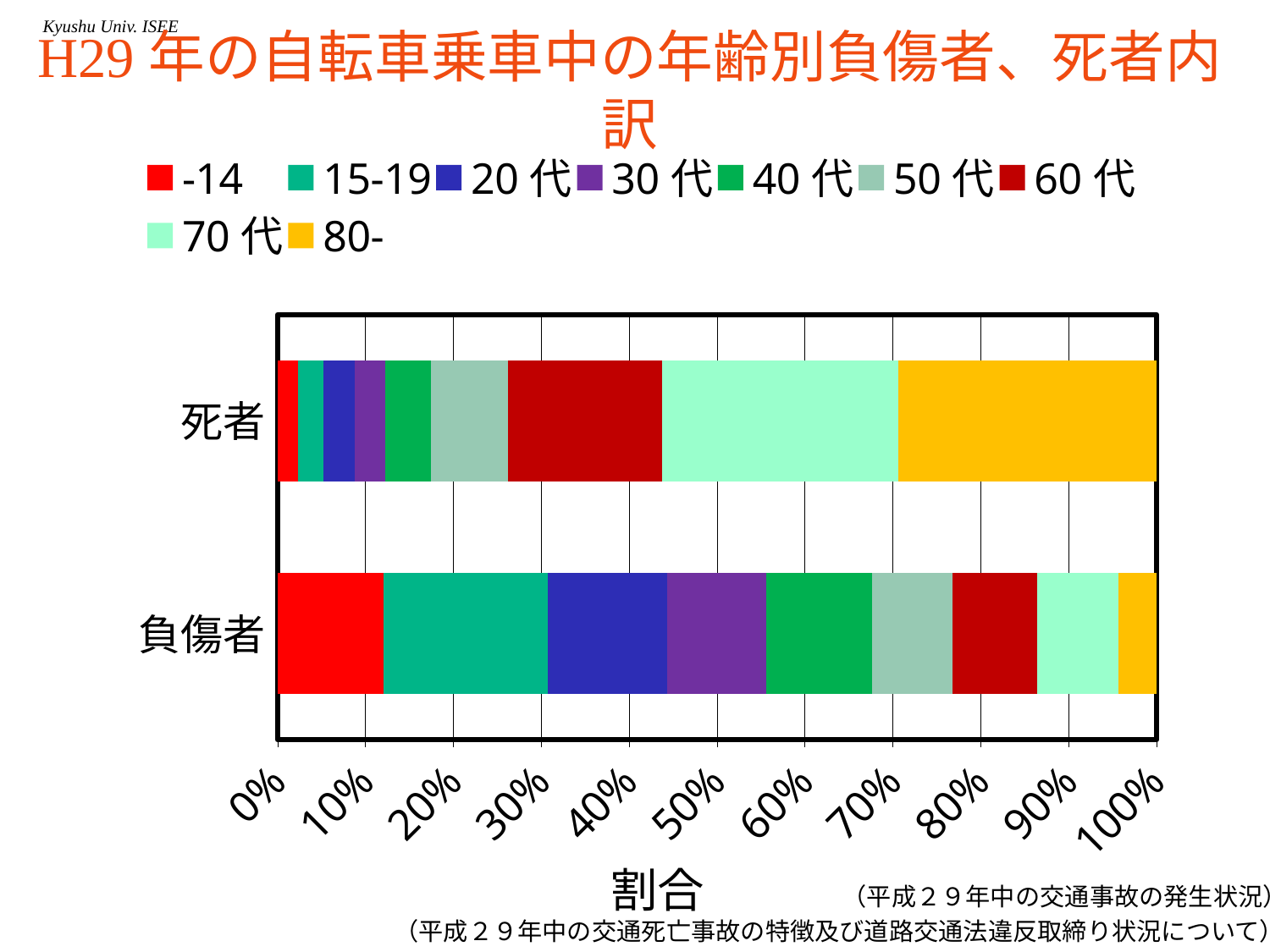
What kind of chart is shown on the slide? Stacked bar chart Within the 負傷者 bar, which age group has the largest share? 15-19 How many bars (categories) does the chart show? 2 Is the share of the -14 group larger in the 死者 bar or the 負傷者 bar? 負傷者 How many series does the legend list? 9 Within the 死者 bar, which age group has the smallest share? -14 Is the share of the -14 group in the 死者 bar greater or less than 10%? less Is the share of the 80- group in the 死者 bar greater or less than 20%? greater What is the label of the horizontal axis? 割合 Is the share of the 80- group larger in the 死者 bar or the 負傷者 bar? 死者 Within the 負傷者 bar, which age group has the smallest share? 80- What are the two categories shown on the vertical axis? 死者 and 負傷者